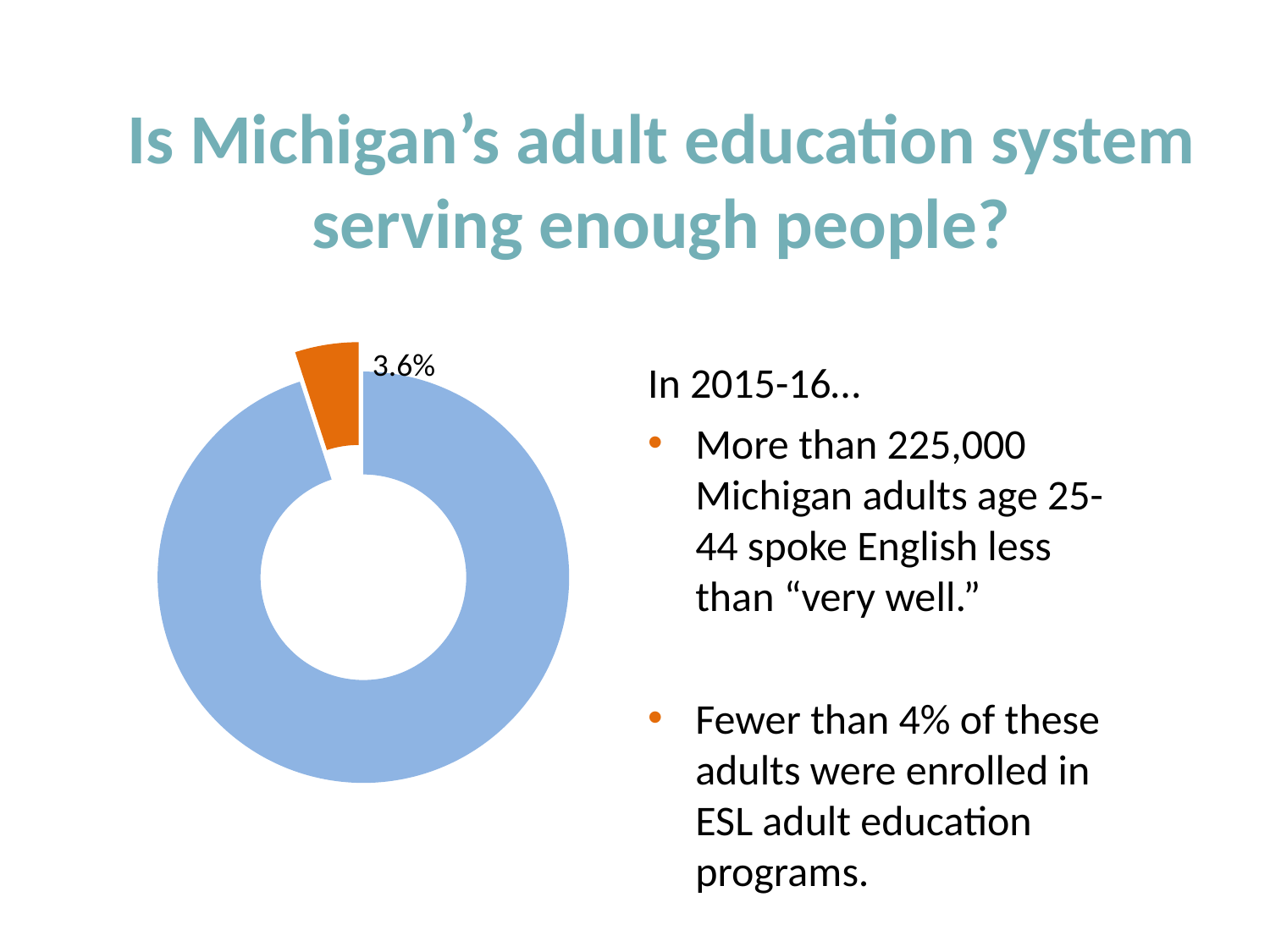
Which colour slice is the largest in the doughnut chart? blue What share of the doughnut chart does the orange slice represent? 3.6% Which slice of the doughnut chart is larger, the blue one or the orange one? the blue one What kind of chart is shown on the slide? doughnut (pie) chart What colour is the slice labelled 3.6% in the doughnut chart? orange What value is labelled on the small orange slice of the doughnut chart? 3.6% Is the blue slice of the doughnut chart greater or less than 50% of the whole? greater How many slices does the doughnut chart have? 2 Which colour slice is the smallest in the doughnut chart? orange Does the doughnut chart include a legend? No